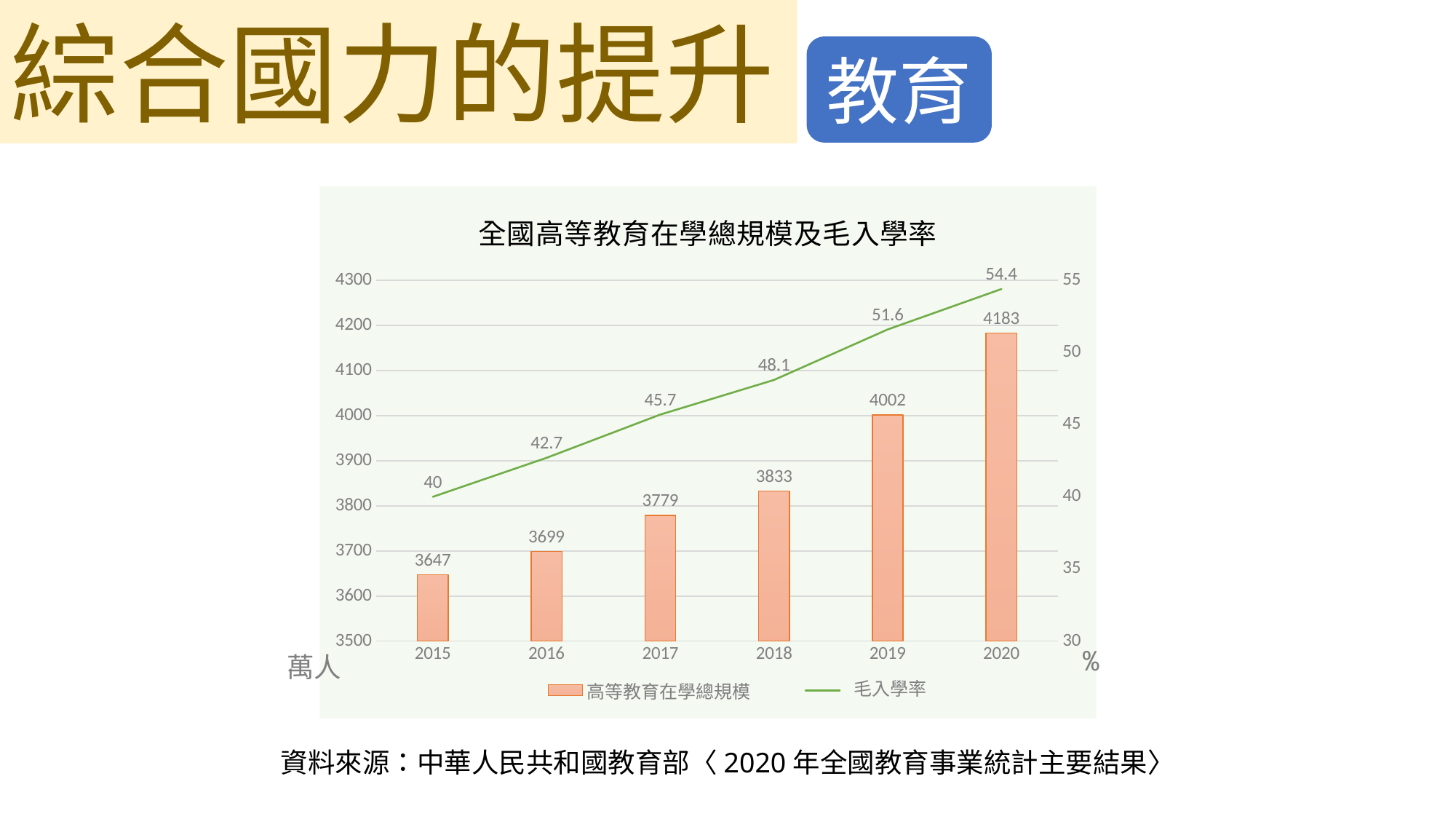
Which year has the highest 高等教育在學總規模? 2020 What is the 毛入學率 for 2017? 45.7 Which is larger, the 高等教育在學總規模 for 2018 or for 2017? 2018 Which year has the lowest 毛入學率? 2015 How many years are shown on the x axis? 6 How many series does the legend list? 2 What is the value of 高等教育在學總規模 for 2015? 3647 What is the value of 高等教育在學總規模 for 2020? 4183 What is the difference in 毛入學率 between 2020 and 2015? 14.4 What is the difference in 高等教育在學總規模 between 2020 and 2019? 181 What kind of chart is this? Combined bar and line chart Does the 毛入學率 rise or fall from 2015 to 2020? Rise